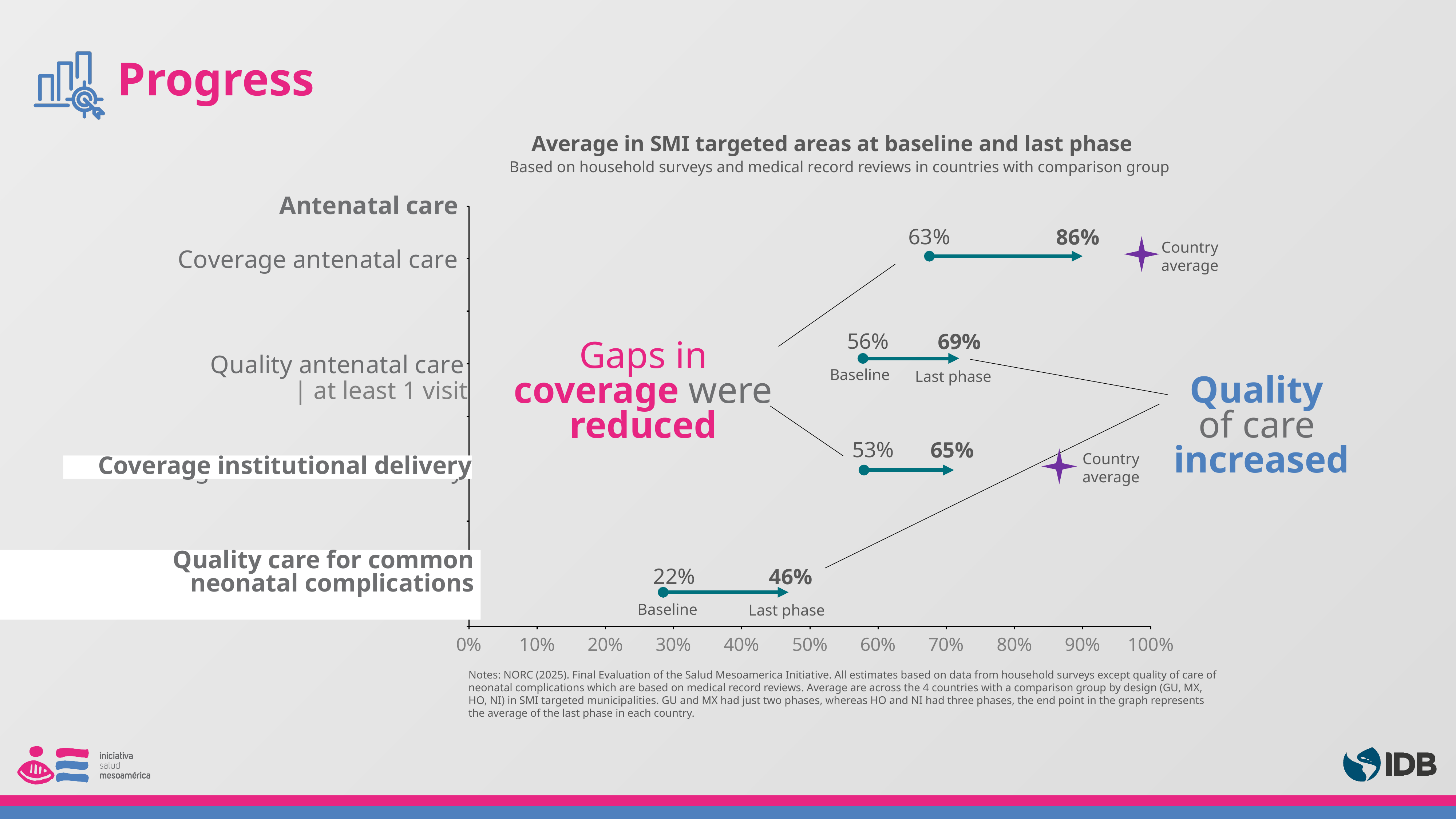
Which is larger: the last phase value for Coverage institutional delivery or the last phase value for Quality antenatal care | at least 1 visit? Quality antenatal care | at least 1 visit What is the difference between the baseline and last phase values for Coverage antenatal care? 23 percentage points What is the last phase value for Quality antenatal care | at least 1 visit? 69% How many indicators are plotted on the chart? 4 What is the title of the chart? Average in SMI targeted areas at baseline and last phase What is the last phase value for Coverage antenatal care? 86% What is the baseline value for Coverage institutional delivery? 53% By how many percentage points did Quality care for common neonatal complications increase from baseline to last phase? 24 percentage points Is the Country average marker for Coverage institutional delivery greater or less than 80%? greater Which indicator has the highest last phase value? Coverage antenatal care Which indicator has the lowest baseline value? Quality care for common neonatal complications What is the baseline value for Quality care for common neonatal complications? 22%